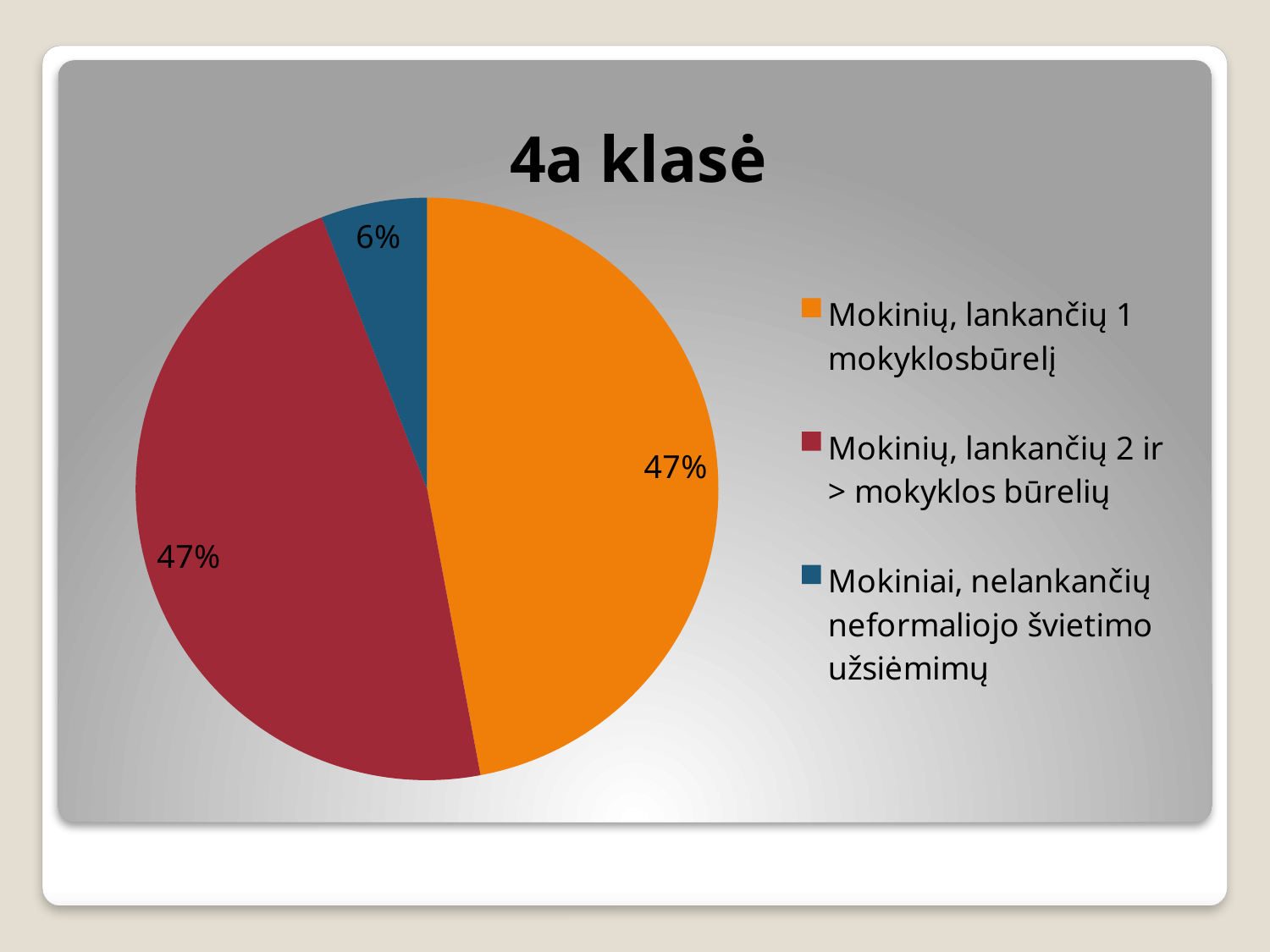
What is the title of the chart? 4a klasė What is the difference in percentage points between the slice for students attending 2 or more school clubs and the slice for students not attending non-formal education activities? 41 percentage points What share of the pie is labelled for students attending 2 or more school clubs (Mokinių, lankančių 2 ir > mokyklos būrelių)? 47% What colour is the slice for students not attending non-formal education activities? Blue What kind of chart is shown on the slide? Pie chart How many slices does the pie chart have? 3 Which is larger: the slice for students attending 1 school club or the slice for students not attending non-formal education activities? Mokinių, lankančių 1 mokyklos būrelį What share of the pie is labelled for students not attending non-formal education activities (Mokiniai, nelankančių neformaliojo švietimo užsiėmimų)? 6% Which category has the smallest slice of the pie? Mokiniai, nelankančių neformaliojo švietimo užsiėmimų What share of the pie is labelled for students attending 1 school club (Mokinių, lankančių 1 mokyklos būrelį)? 47% How many entries does the legend list? 3